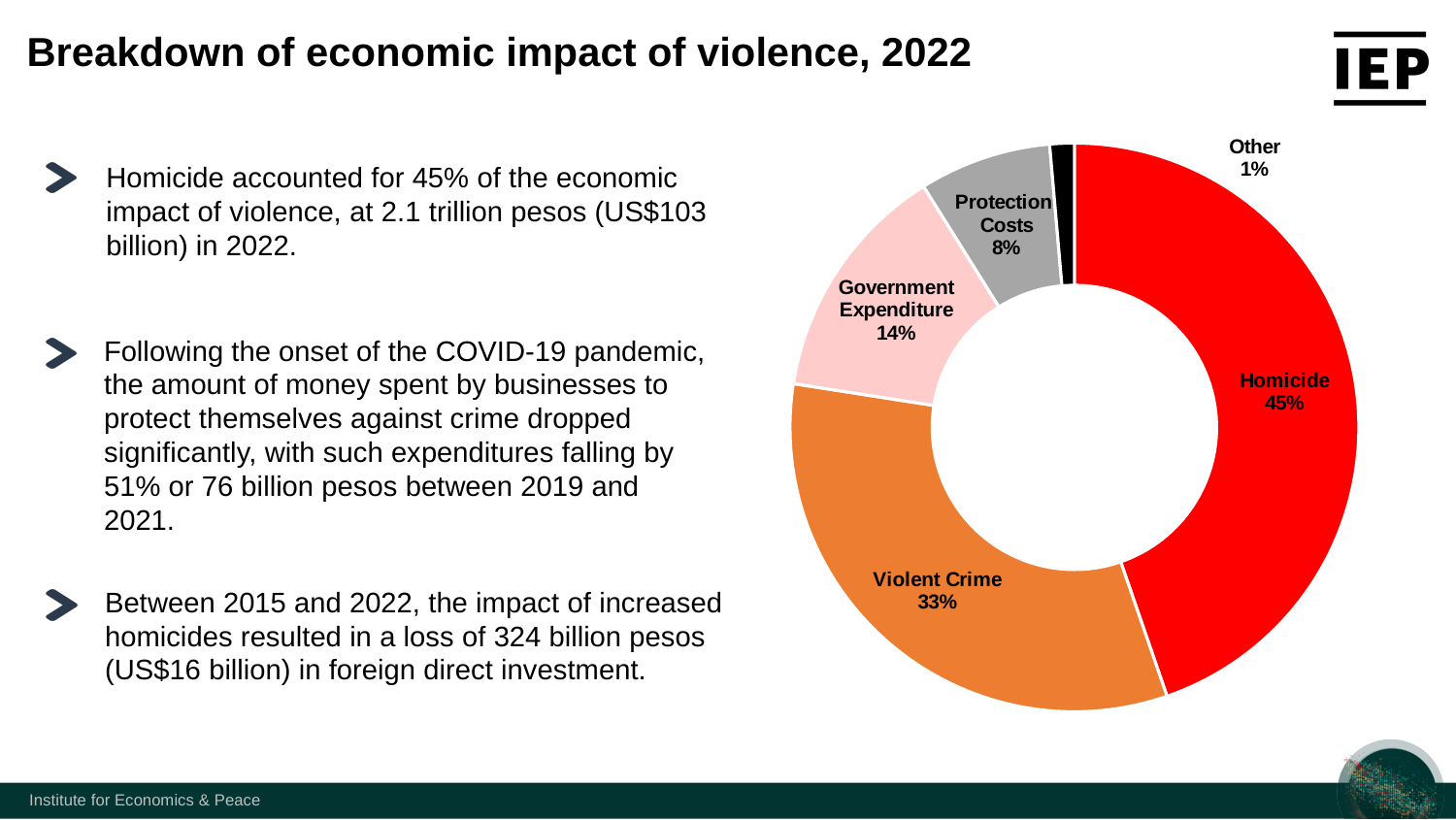
What share of the chart is Violent Crime? 33% What is the title of the chart on the slide? Breakdown of economic impact of violence, 2022 What share of the economic impact of violence does Homicide account for in the chart? 45% What percentage is shown for Government Expenditure? 14% Which category has the largest share of the chart? Homicide Which is larger, Government Expenditure or Protection Costs? Government Expenditure What kind of chart is shown on the slide? Pie chart (doughnut) What percentage is shown for Protection Costs? 8% Which category has the smallest share of the chart? Other What percentage is shown for the Other category? 1% What is the difference in percentage points between Homicide and Violent Crime? 12 How many categories are shown in the chart? 5